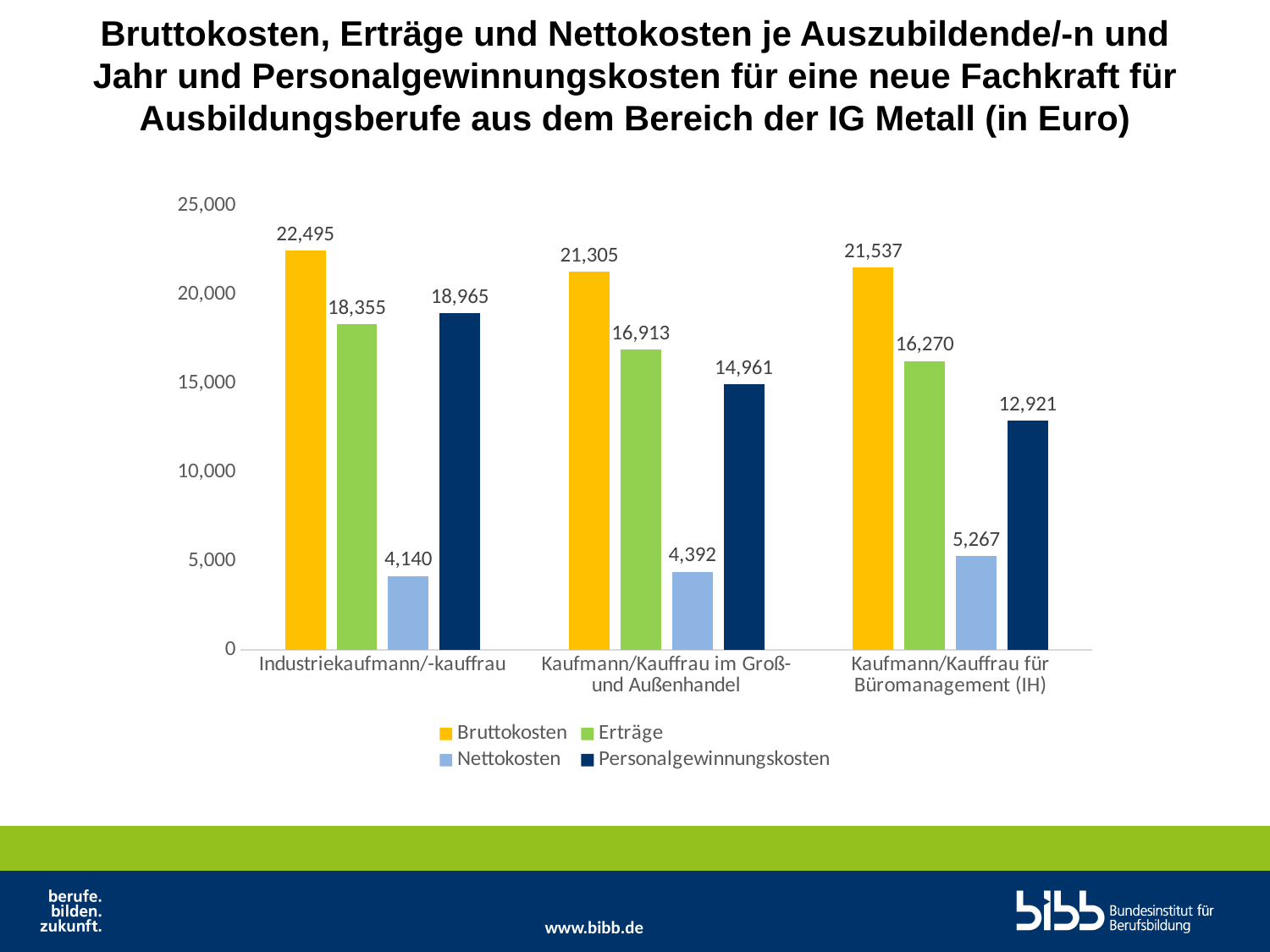
What is the Bruttokosten value for Industriekaufmann/-kauffrau? 22,495 How many series does the legend list? 4 What is the Personalgewinnungskosten value for Kaufmann/Kauffrau für Büromanagement (IH)? 12,921 How many categories are shown on the x axis? 3 What is the Erträge value for Kaufmann/Kauffrau für Büromanagement (IH)? 16,270 Which colour represents Personalgewinnungskosten in the legend? Dark blue Which category has the highest Nettokosten? Kaufmann/Kauffrau für Büromanagement (IH) What kind of chart is shown on the slide? Bar chart Which is larger for Kaufmann/Kauffrau im Groß- und Außenhandel: Erträge or Personalgewinnungskosten? Erträge What is the difference between Bruttokosten and Erträge for Industriekaufmann/-kauffrau? 4,140 What is the Nettokosten value for Kaufmann/Kauffrau im Groß- und Außenhandel? 4,392 Which category has the lowest Personalgewinnungskosten? Kaufmann/Kauffrau für Büromanagement (IH)